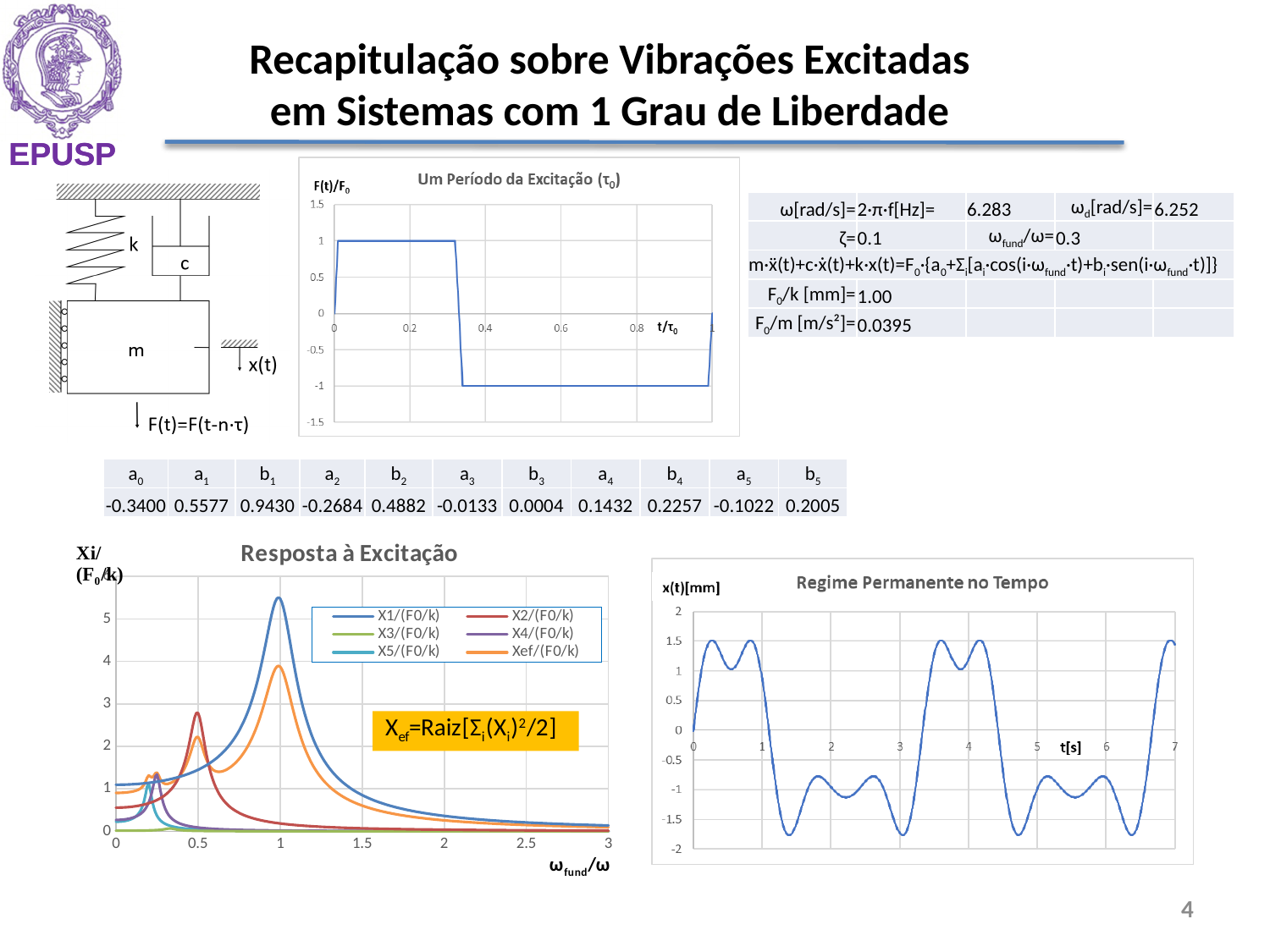
In the 'Resposta à Excitação' chart, is the peak value of X2/(F0/k) greater or less than 2? greater In the 'Um Período da Excitação (τ0)' chart, what is the highest value of the y axis scale? 1.5 In the 'Regime Permanente no Tempo' chart, is the highest value of x(t) greater or less than 1? greater What kind of chart is the 'Regime Permanente no Tempo' chart? line chart In the 'Resposta à Excitação' chart, which series reaches the highest peak? X1/(F0/k) In the 'Resposta à Excitação' chart, is the peak value of X1/(F0/k) greater or less than 5? greater How many series does the legend of the 'Resposta à Excitação' chart list? 6 What is the label of the x axis of the 'Resposta à Excitação' chart? ωfund/ω What kind of chart is the 'Um Período da Excitação (τ0)' chart? line chart